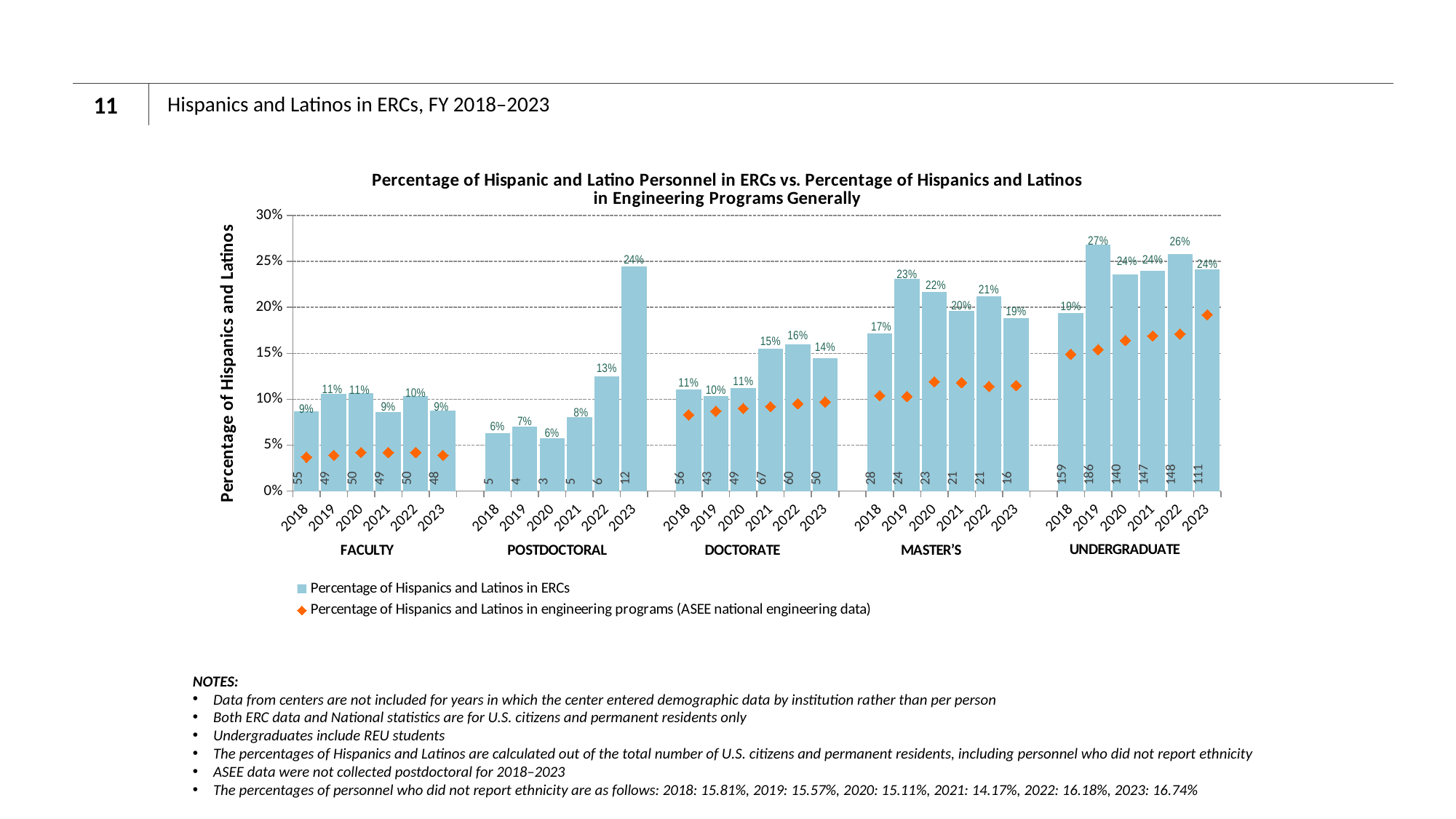
Which has the higher ERC percentage in 2022: Doctorate or Faculty? Doctorate In the Undergraduate group, which year has the highest percentage of Hispanics and Latinos in ERCs? 2019 How many percentage points higher is the Postdoctoral ERC percentage in 2023 than in 2022? 11 percentage points From 2018 to 2023, does the Postdoctoral ERC percentage generally rise or fall? Rise What number is printed inside the Undergraduate bar for 2019? 186 How many years are plotted within each personnel group? 6 What kind of chart is used to show the percentage of Hispanics and Latinos in ERCs? Bar chart What percentage of Hispanics and Latinos in ERCs is shown for Postdoctoral in 2023? 24% How many series does the legend list? 2 What percentage of Hispanics and Latinos in ERCs is shown for Master's in 2019? 23% In the Master's group, which year has the lowest percentage of Hispanics and Latinos in ERCs? 2018 Is the ASEE national engineering data value (orange diamond) for Undergraduate in 2023 greater or less than 15%? greater